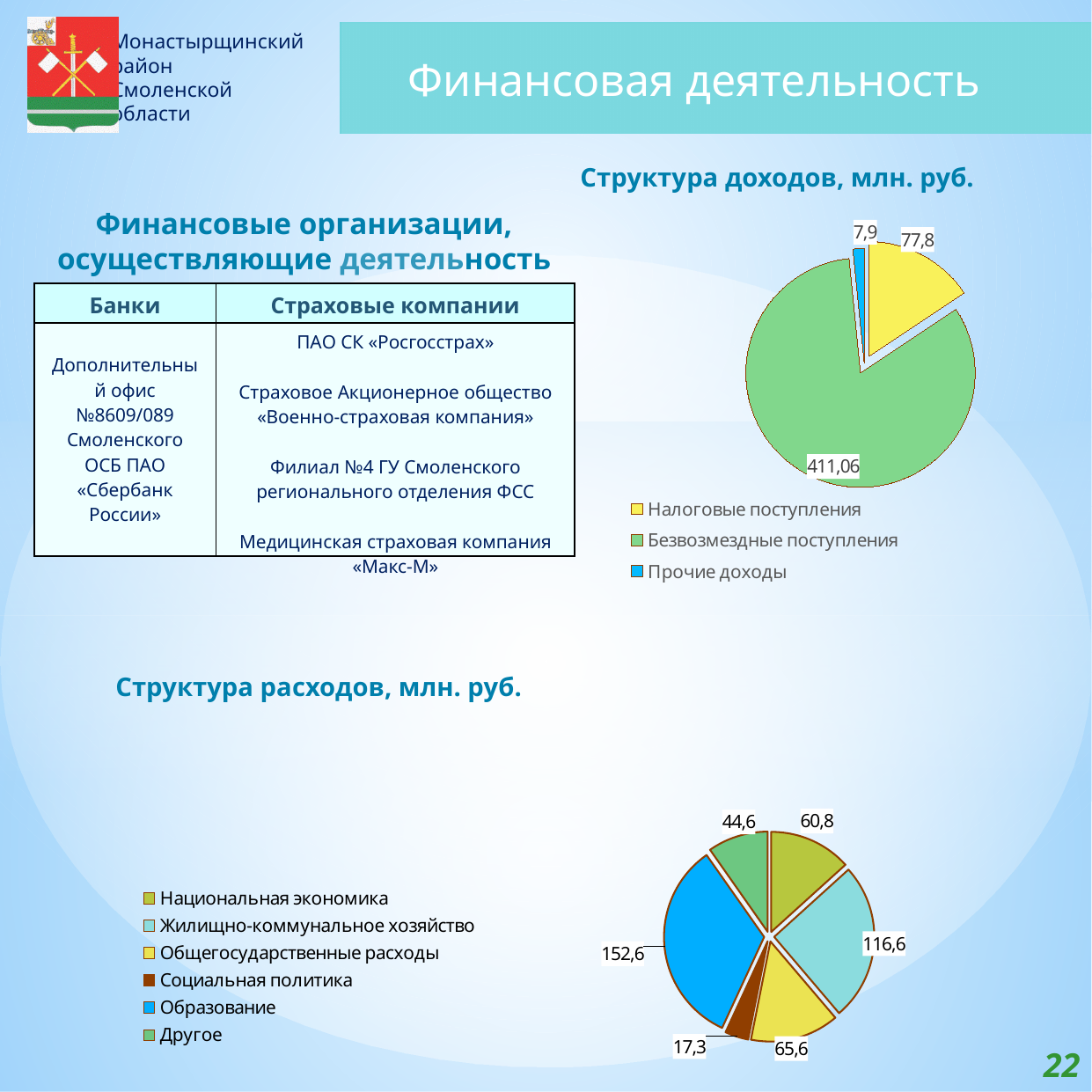
In the chart 'Структура доходов, млн. руб.', what is the value for Безвозмездные поступления? 411,06 What type of chart is 'Структура расходов, млн. руб.'? Pie chart In the chart 'Структура расходов, млн. руб.', which is larger: Жилищно-коммунальное хозяйство or Общегосударственные расходы? Жилищно-коммунальное хозяйство In the chart 'Структура доходов, млн. руб.', what is the value for Налоговые поступления? 77,8 In the chart 'Структура расходов, млн. руб.', what is the value for Образование? 152,6 In the chart 'Структура расходов, млн. руб.', how many categories are shown? 6 In the chart 'Структура доходов, млн. руб.', how many categories does the legend list? 3 In the chart 'Структура расходов, млн. руб.', what is the value for Социальная политика? 17,3 In the chart 'Структура доходов, млн. руб.', which category has the smallest value? Прочие доходы In the chart 'Структура расходов, млн. руб.', which category has the largest value? Образование In the chart 'Структура доходов, млн. руб.', what is the difference between Налоговые поступления and Прочие доходы? 69,9 In the chart 'Структура расходов, млн. руб.', what is the difference between Национальная экономика and Другое? 16,2